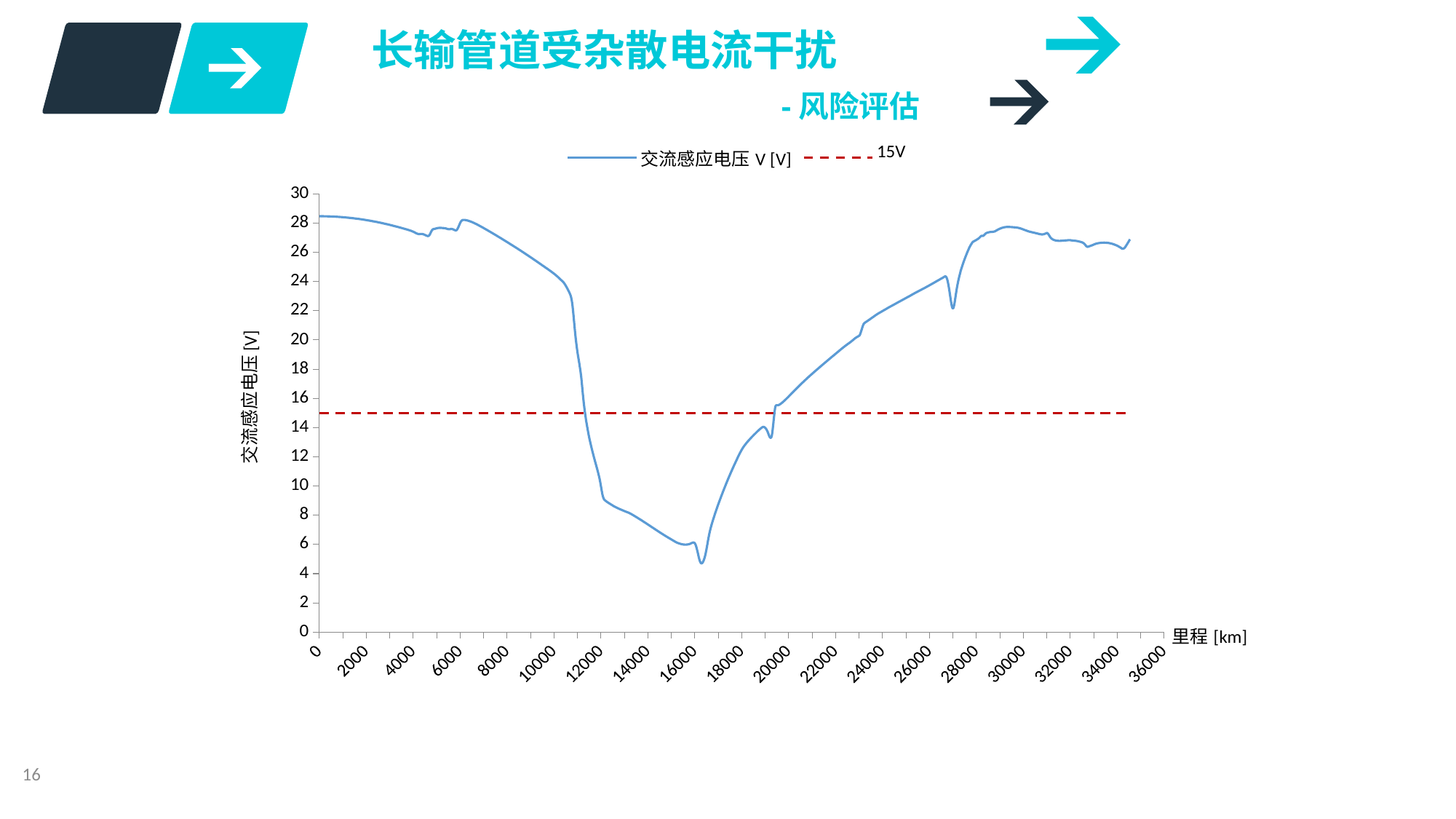
Does the 交流感应电压 V [V] line rise or fall between 18000 km and 30000 km? rise What kind of chart is shown on the slide? line chart How many series does the legend list? 2 Does the 交流感应电压 V [V] line rise or fall between 6000 km and 16000 km? fall What is the label of the dashed red series in the legend? 15V Is the value of 交流感应电压 V [V] at 30000 km greater or less than 26? greater Which is larger, the 交流感应电压 V [V] value at 0 km or at 16000 km? 0 km Is the value of 交流感应电压 V [V] at 0 km greater or less than 26? greater Is the value of 交流感应电压 V [V] at 8000 km greater or less than 24? greater What is the title of the x axis? 里程 [km]